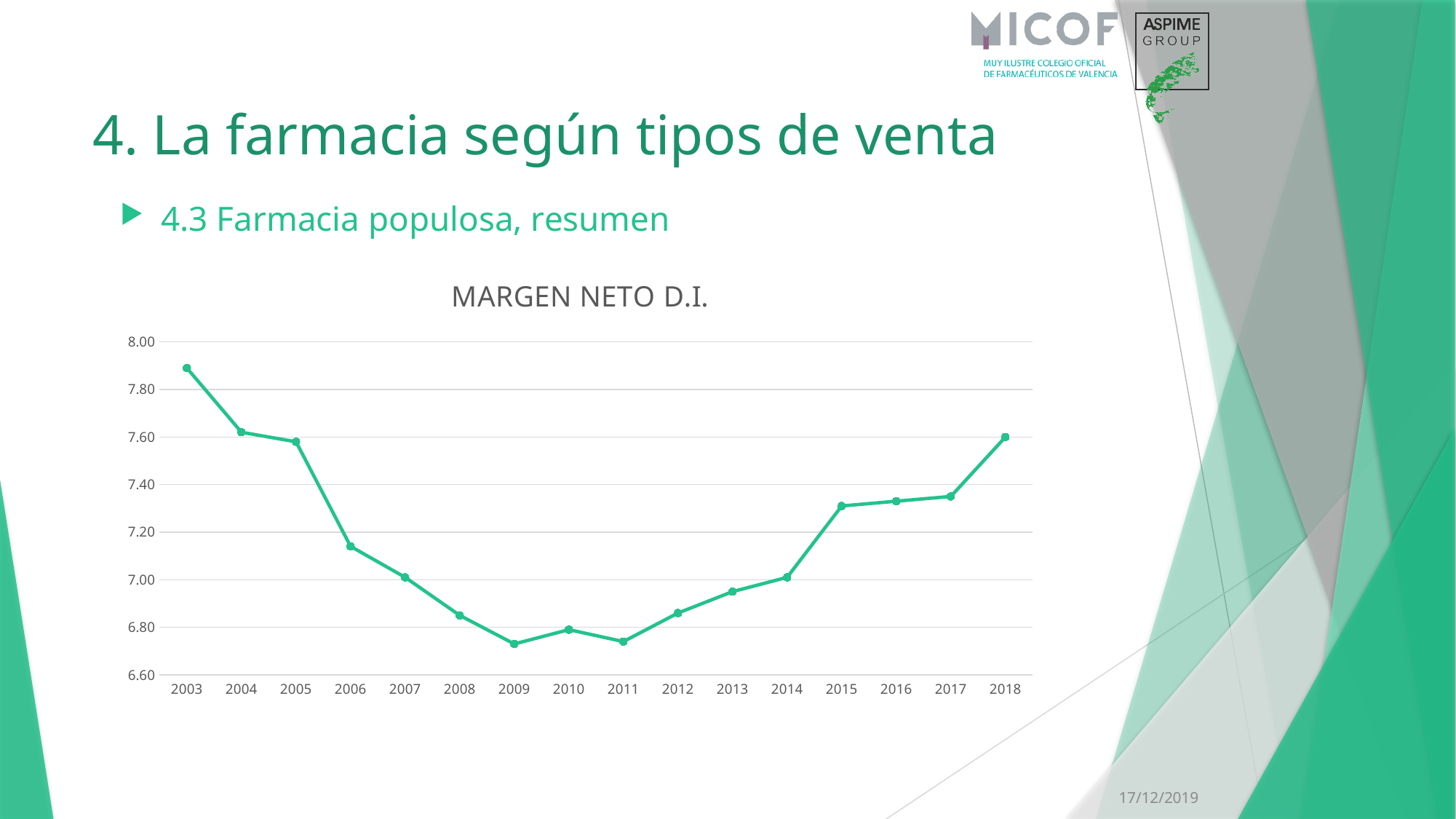
Which is larger, the value for 2010 or the value for 2012? 2012 How many years are plotted on the x axis of the chart? 16 Is the value for 2003 greater or less than 7.80? greater What is the title of the chart? MARGEN NETO D.I. Which year has the highest value in the chart? 2003 Is the value for 2015 greater or less than 7.20? greater Do the values rise or fall from 2003 to 2009? fall Is the value for 2009 greater or less than 6.80? less Which is larger, the value for 2003 or the value for 2018? 2003 What kind of chart is shown on the slide? Line chart